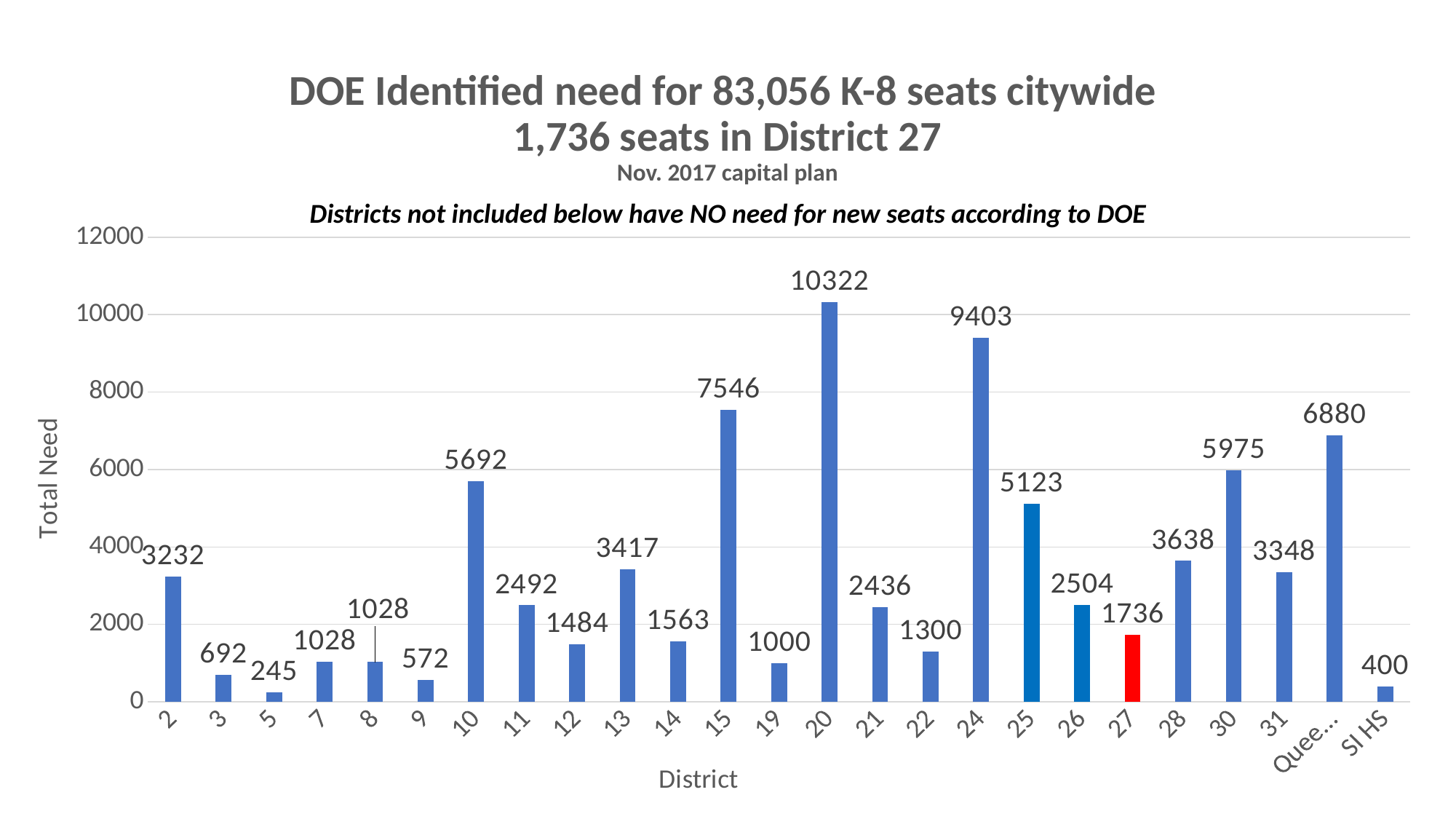
How many districts (categories) are shown on the x axis? 25 Which district has the highest total need? 20 What is the total need for District 15? 7546 Which district's bar is coloured red? 27 What is the difference in total need between District 27 and District 26? 768 What is the total need for District 27? 1736 What is the difference in total need between District 20 and District 24? 919 Which district has the lowest total need? 5 What kind of chart is shown on the slide? Bar chart Is the value for District 25 greater or less than 4000? greater What is the total need for SI HS? 400 Which has a larger total need, District 10 or District 30? District 30